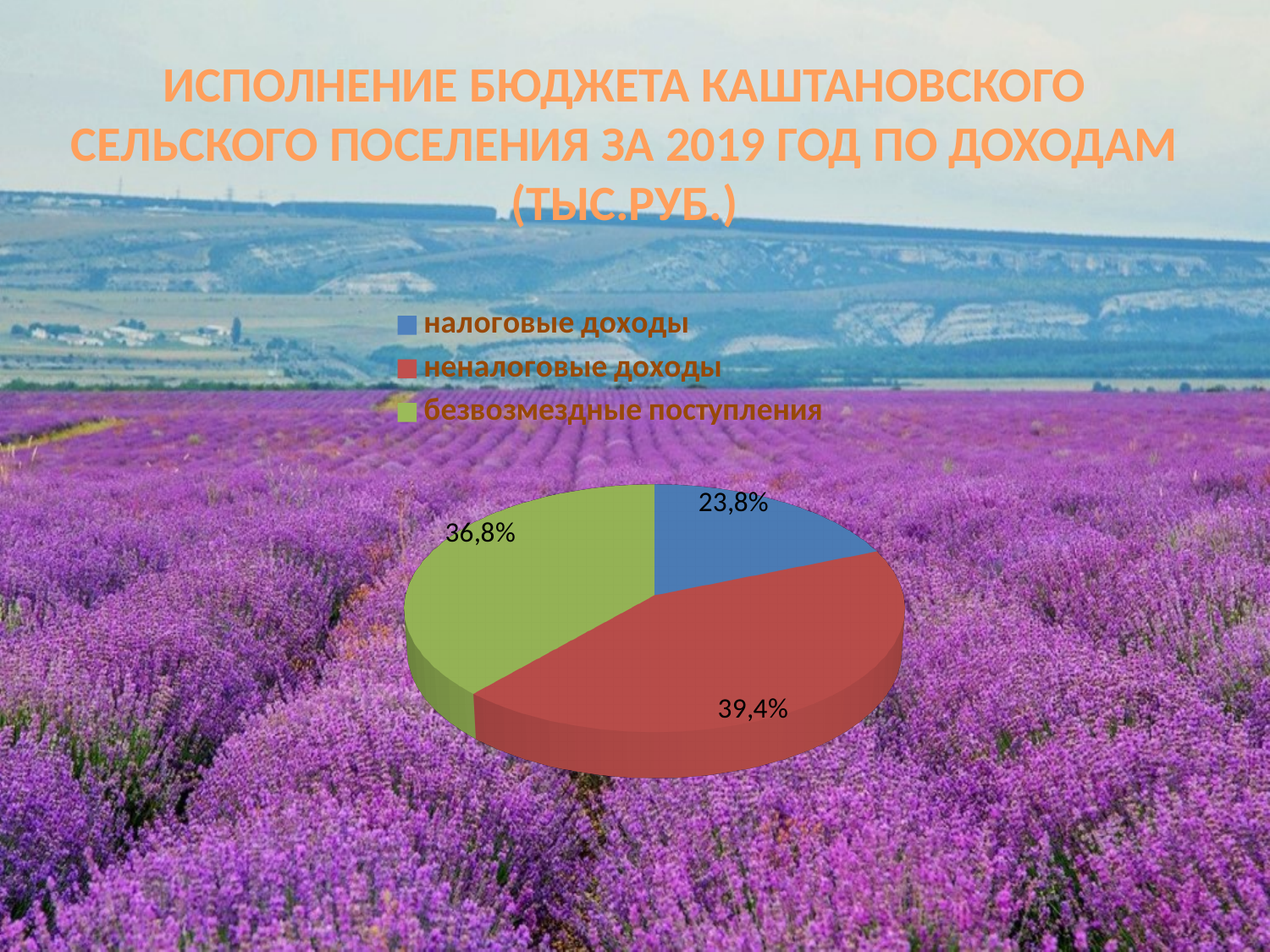
What kind of chart is shown on the slide? pie chart How many slices does the pie chart have? 3 What colour is the slice for безвозмездные поступления? green What is the title of the chart on the slide? ИСПОЛНЕНИЕ БЮДЖЕТА КАШТАНОВСКОГО СЕЛЬСКОГО ПОСЕЛЕНИЯ ЗА 2019 ГОД ПО ДОХОДАМ (ТЫС.РУБ.) What share of the pie does неналоговые доходы have? 39,4% What is the difference in percentage points between неналоговые доходы and налоговые доходы? 15,6 Which category has the largest share of the pie? неналоговые доходы How many entries does the legend list? 3 Which is larger: the share for безвозмездные поступления or the share for налоговые доходы? безвозмездные поступления What share of the pie does налоговые доходы have? 23,8% Which category has the smallest share of the pie? налоговые доходы What share of the pie does безвозмездные поступления have? 36,8%